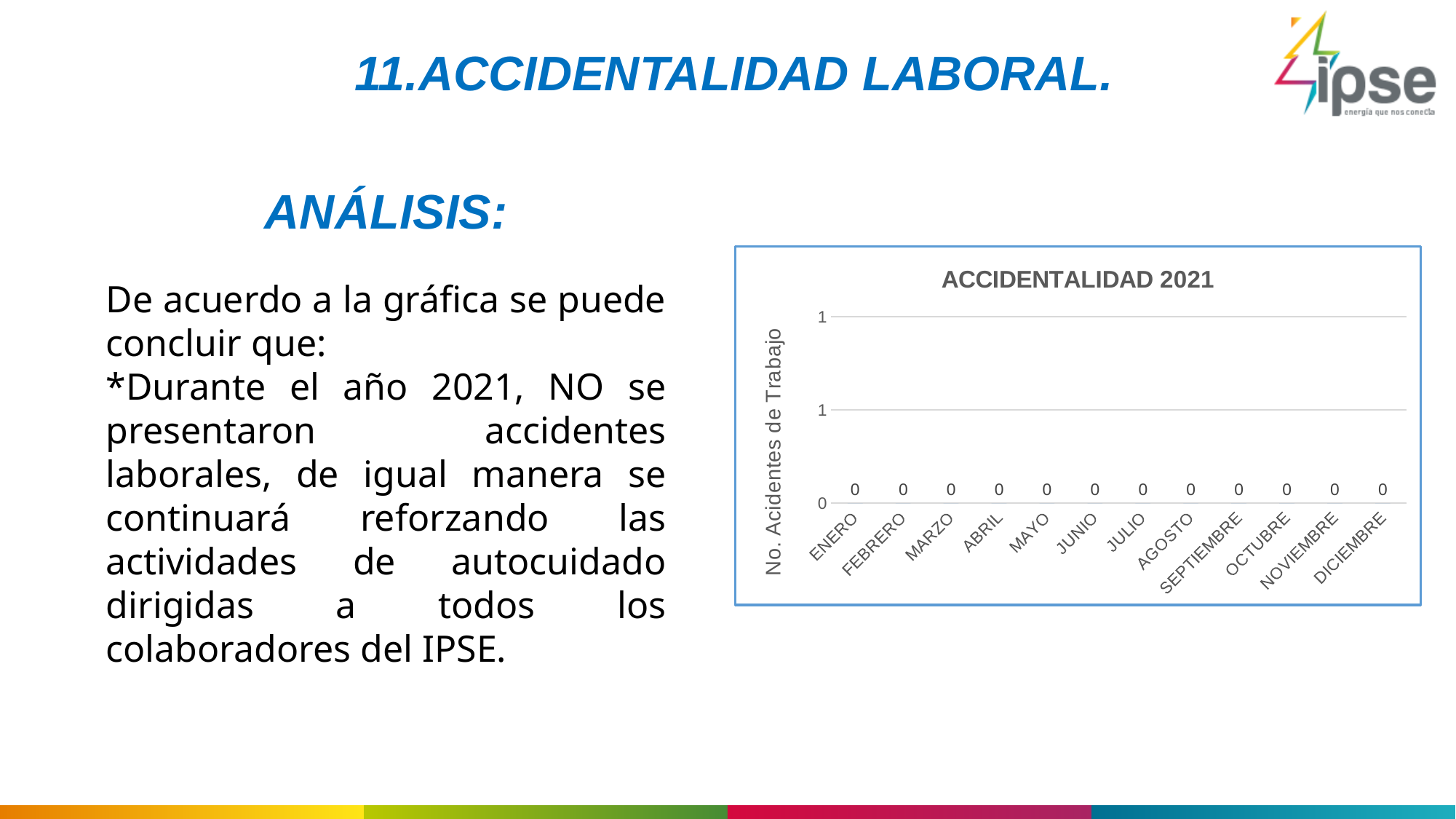
What is the difference between the values for MARZO and OCTUBRE in the ACCIDENTALIDAD 2021 chart? 0 How many categories (months) are shown on the x axis of the ACCIDENTALIDAD 2021 chart? 12 What is the value for ENERO in the ACCIDENTALIDAD 2021 chart? 0 What is the value for JULIO in the ACCIDENTALIDAD 2021 chart? 0 Do the values in the ACCIDENTALIDAD 2021 chart rise, fall, or stay the same from ENERO to DICIEMBRE? stay the same What is the value for SEPTIEMBRE in the ACCIDENTALIDAD 2021 chart? 0 Which month is the first category on the x axis of the ACCIDENTALIDAD 2021 chart? ENERO Is the value for MAYO in the ACCIDENTALIDAD 2021 chart greater or less than 1? less What is the label on the y axis of the ACCIDENTALIDAD 2021 chart? No. Acidentes de Trabajo What is the total of all monthly values shown in the ACCIDENTALIDAD 2021 chart? 0 What is the value for DICIEMBRE in the ACCIDENTALIDAD 2021 chart? 0 What is the title of the chart on the slide? ACCIDENTALIDAD 2021